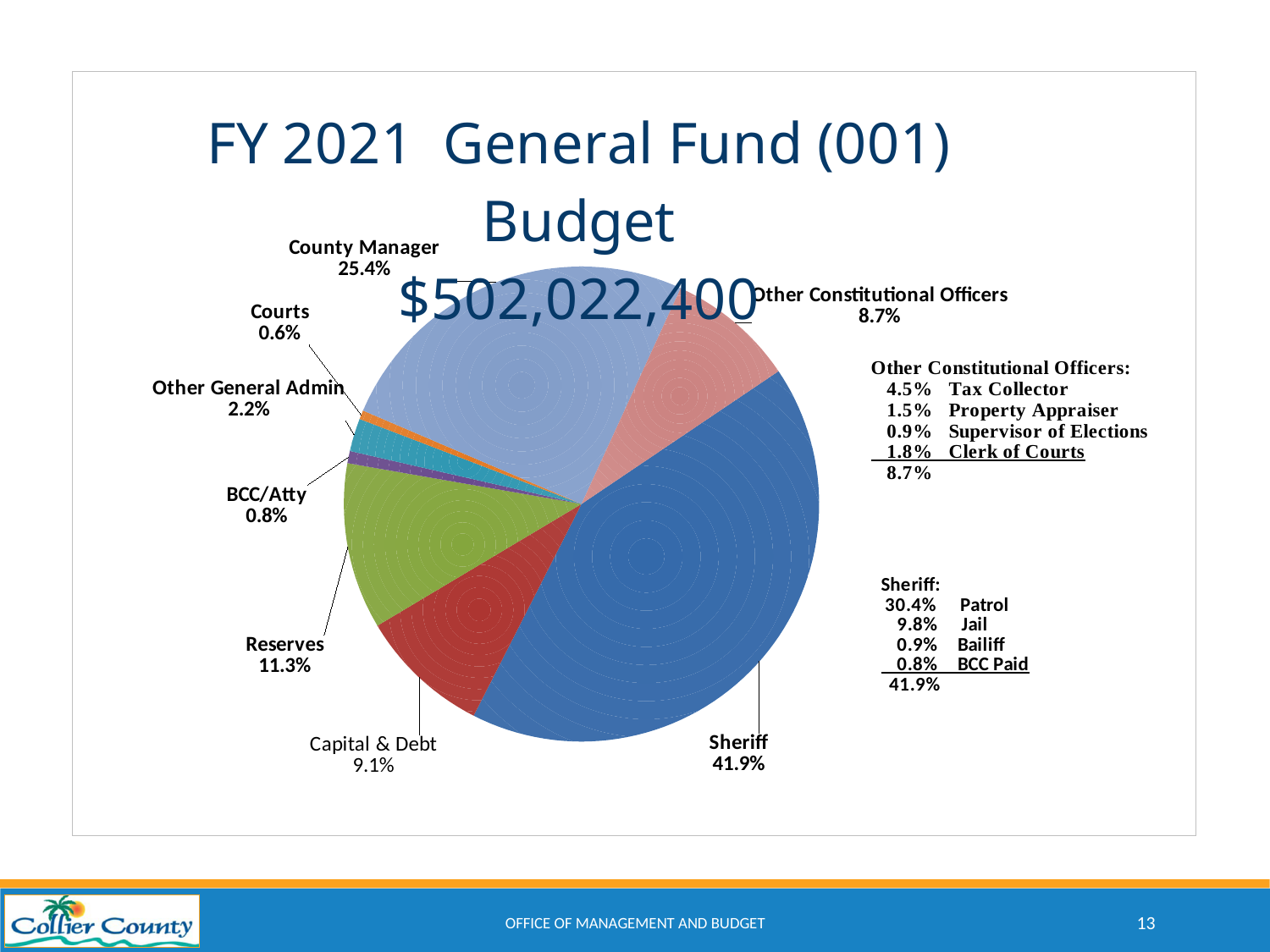
What is the value shown for Other Constitutional Officers? 8.7% How many slices does the pie chart have? 8 What is the value shown for Capital & Debt? 9.1% What kind of chart is shown on the slide? pie chart What share of the pie does the Sheriff slice represent? 41.9% What total budget amount is shown in the chart title? $502,022,400 What is the value shown for Reserves? 11.3% Which category has the smallest share of the pie? Courts Which is larger, the share for Reserves or the share for Capital & Debt? Reserves What is the difference between the Sheriff share and the County Manager share? 16.5% What is the value shown for County Manager? 25.4% Which category has the largest share of the pie? Sheriff